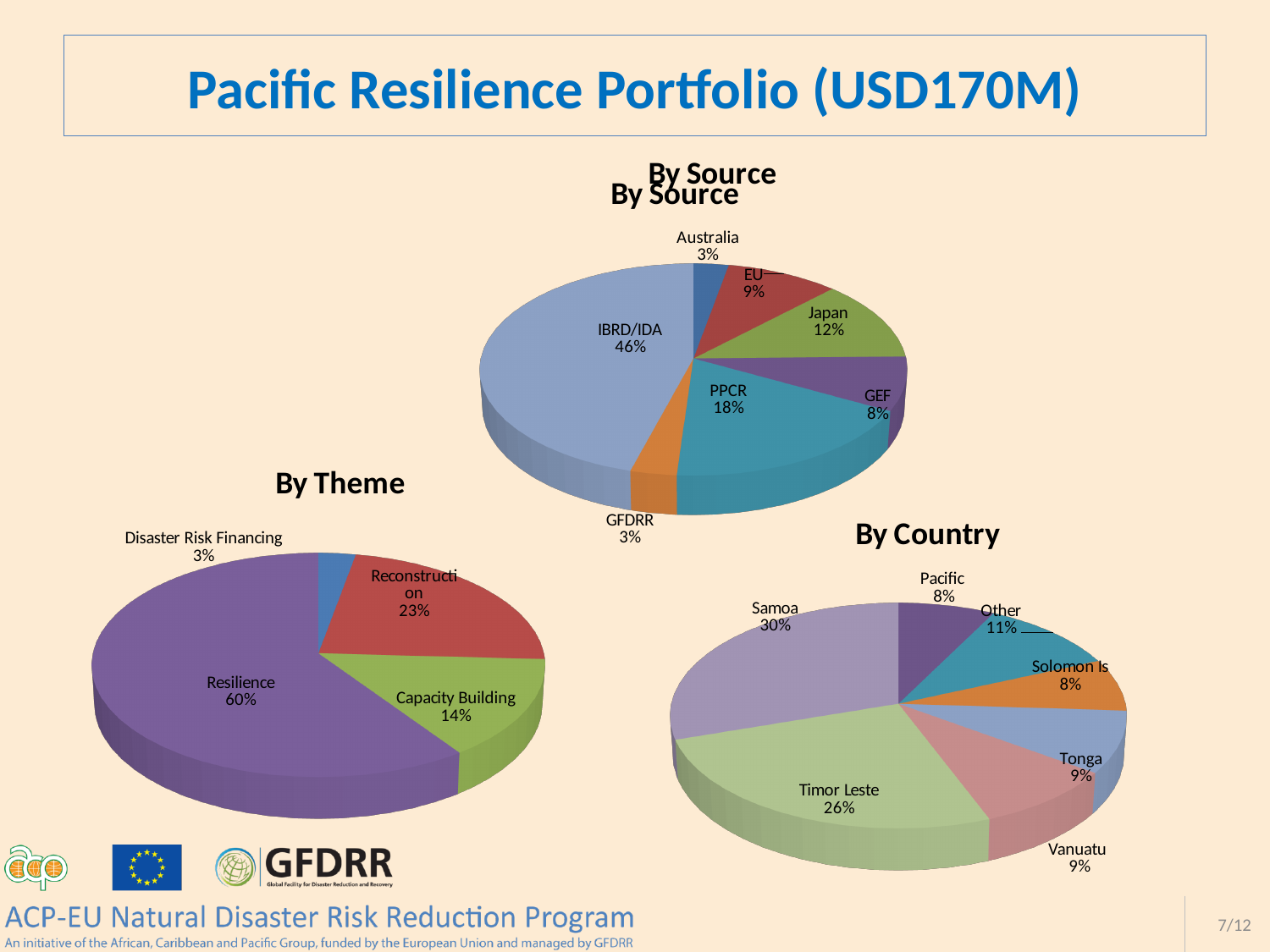
In the By Theme chart, what share does Resilience account for? 60% In the By Source chart, what is the difference in percentage points between Japan and EU? 3 In the By Source chart, what share does PPCR account for? 18% In the By Country chart, which country has the largest share? Samoa In the By Theme chart, which theme has the smallest share? Disaster Risk Financing In the By Source chart, how many sources are shown? 7 In the By Country chart, how many categories are shown? 7 In the By Theme chart, which is larger, Reconstruction or Capacity Building? Reconstruction In the By Source chart, which source has the largest share? IBRD/IDA What kind of chart is the By Country chart? Pie chart In the By Source chart, what share does IBRD/IDA account for? 46% In the By Country chart, what share does Timor Leste account for? 26%